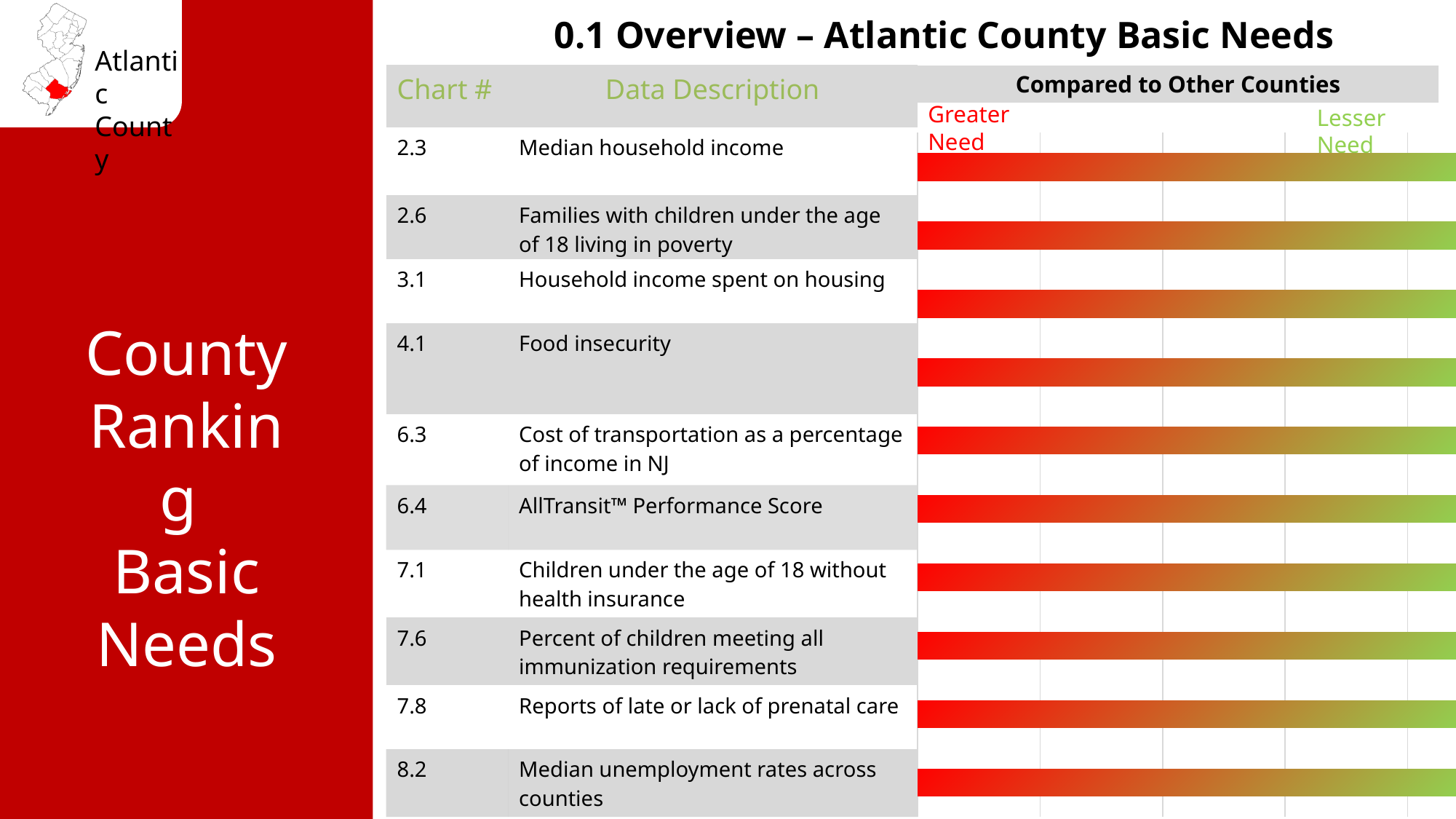
Which data description is listed for chart number 6.4? AllTransit™ Performance Score Which chart number is listed for 'Median household income'? 2.3 Which chart number is listed for 'Food insecurity'? 4.1 How many data descriptions (rows) are listed in the table? 10 Which data description is listed for chart number 8.2? Median unemployment rates across counties What label appears at the right end of the 'Compared to Other Counties' scale? Lesser Need Which chart number is listed for 'Reports of late or lack of prenatal care'? 7.8 What label appears at the left end of the 'Compared to Other Counties' scale? Greater Need What kind of chart is used in the 'Compared to Other Counties' column? bar chart